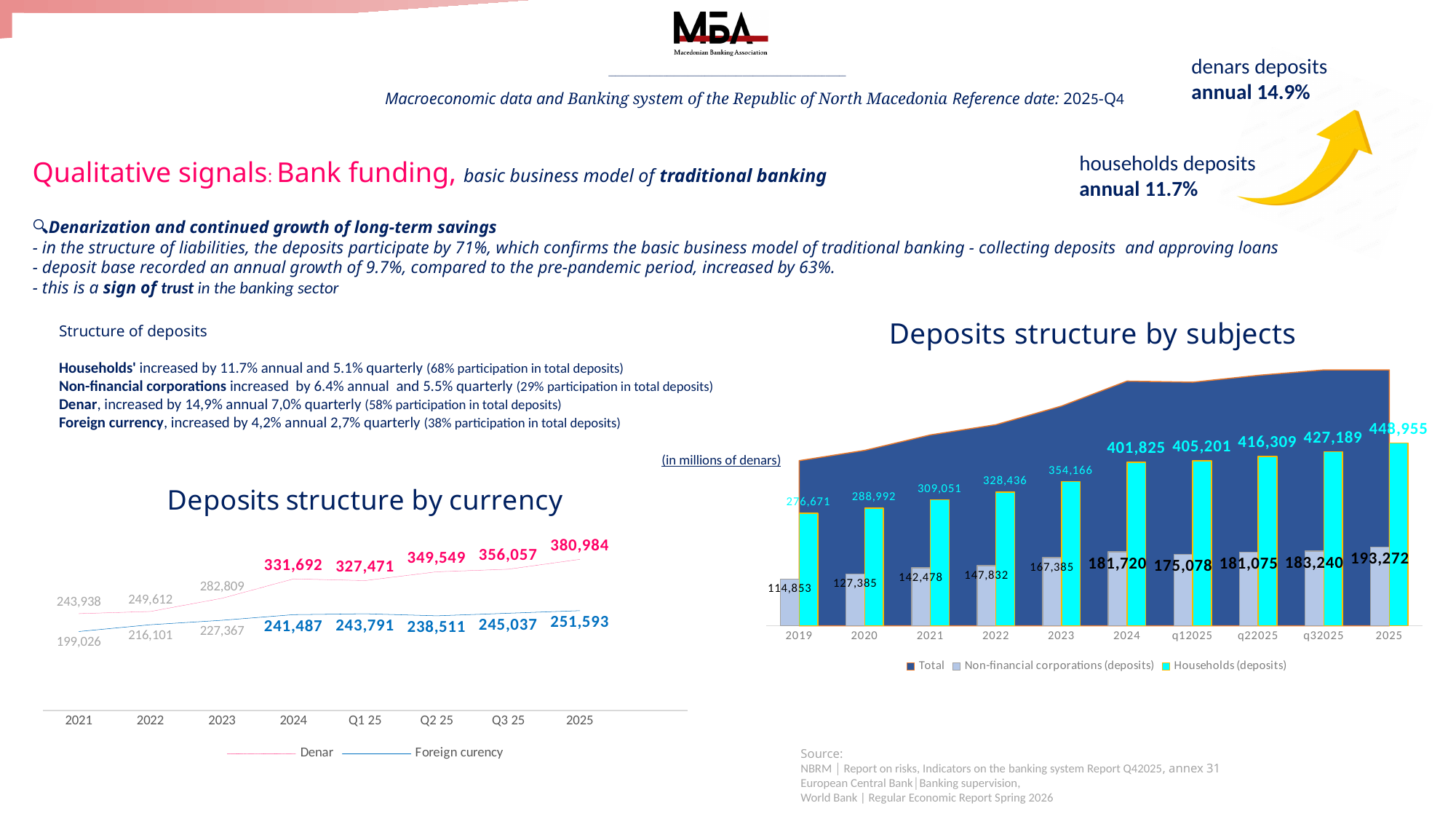
In the 'Deposits structure by currency' chart, what is the Denar value for 2025? 380,984 In the 'Deposits structure by currency' chart, what is the Foreign currency value for Q2 25? 238,511 In the 'Deposits structure by subjects' chart, how many series does the legend list? 3 In the 'Deposits structure by subjects' chart, what is the Non-financial corporations (deposits) value for q32025? 183,240 In the 'Deposits structure by currency' chart, which period has the lowest Foreign currency value? 2021 In the 'Deposits structure by currency' chart, what is the difference between the Denar and Foreign currency values for 2021? 44,912 In the 'Deposits structure by currency' chart, how many series does the legend list? 2 In the 'Deposits structure by currency' chart, how many time periods are shown on the x axis? 8 In the 'Deposits structure by subjects' chart, what is the difference between the Households (deposits) values for 2025 and 2024? 47,130 In the 'Deposits structure by subjects' chart, which period has the highest Households (deposits) value? 2025 In the 'Deposits structure by subjects' chart, what is the Households (deposits) value for 2023? 354,166 In the 'Deposits structure by subjects' chart, which is larger: Non-financial corporations (deposits) in 2024 or in q12025? 2024